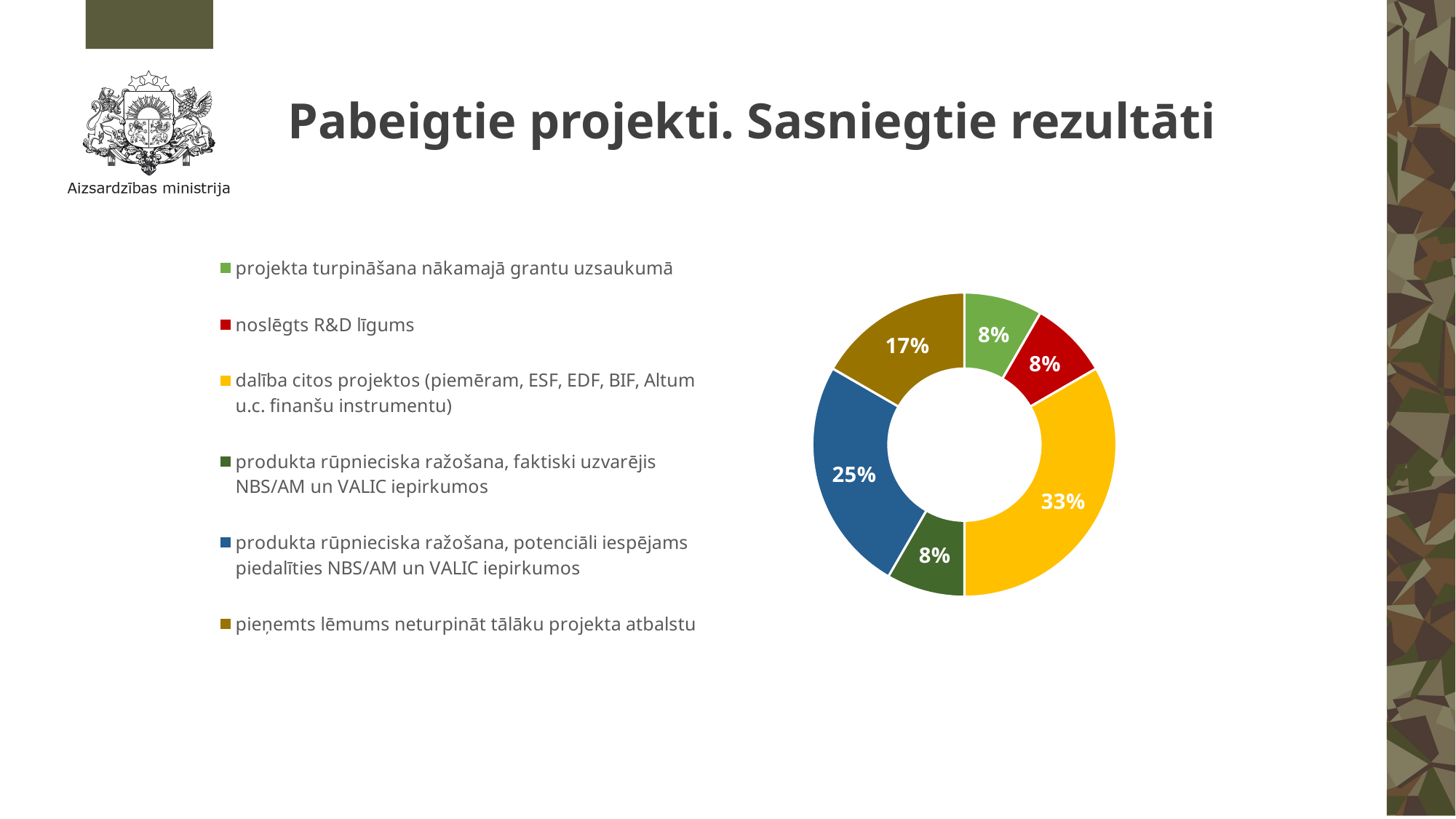
What is the difference in percentage points between the 'dalība citos projektos' slice and the 'produkta rūpnieciska ražošana, potenciāli iespējams piedalīties NBS/AM un VALIC iepirkumos' slice? 8 percentage points How many entries does the chart legend list? 6 What share of the chart is 'projekta turpināšana nākamajā grantu uzsaukumā'? 8% What share of the chart is 'noslēgts R&D līgums'? 8% What colour is the slice for 'noslēgts R&D līgums'? red What share of the chart is 'pieņemts lēmums neturpināt tālāku projekta atbalstu'? 17% Which category has the largest share of the chart? dalība citos projektos (piemēram, ESF, EDF, BIF, Altum u.c. finanšu instrumentu) Which is larger: the share for 'produkta rūpnieciska ražošana, potenciāli iespējams piedalīties NBS/AM un VALIC iepirkumos' or the share for 'pieņemts lēmums neturpināt tālāku projekta atbalstu'? produkta rūpnieciska ražošana, potenciāli iespējams piedalīties NBS/AM un VALIC iepirkumos What kind of chart is shown on the slide? doughnut chart How many slices does the chart have? 6